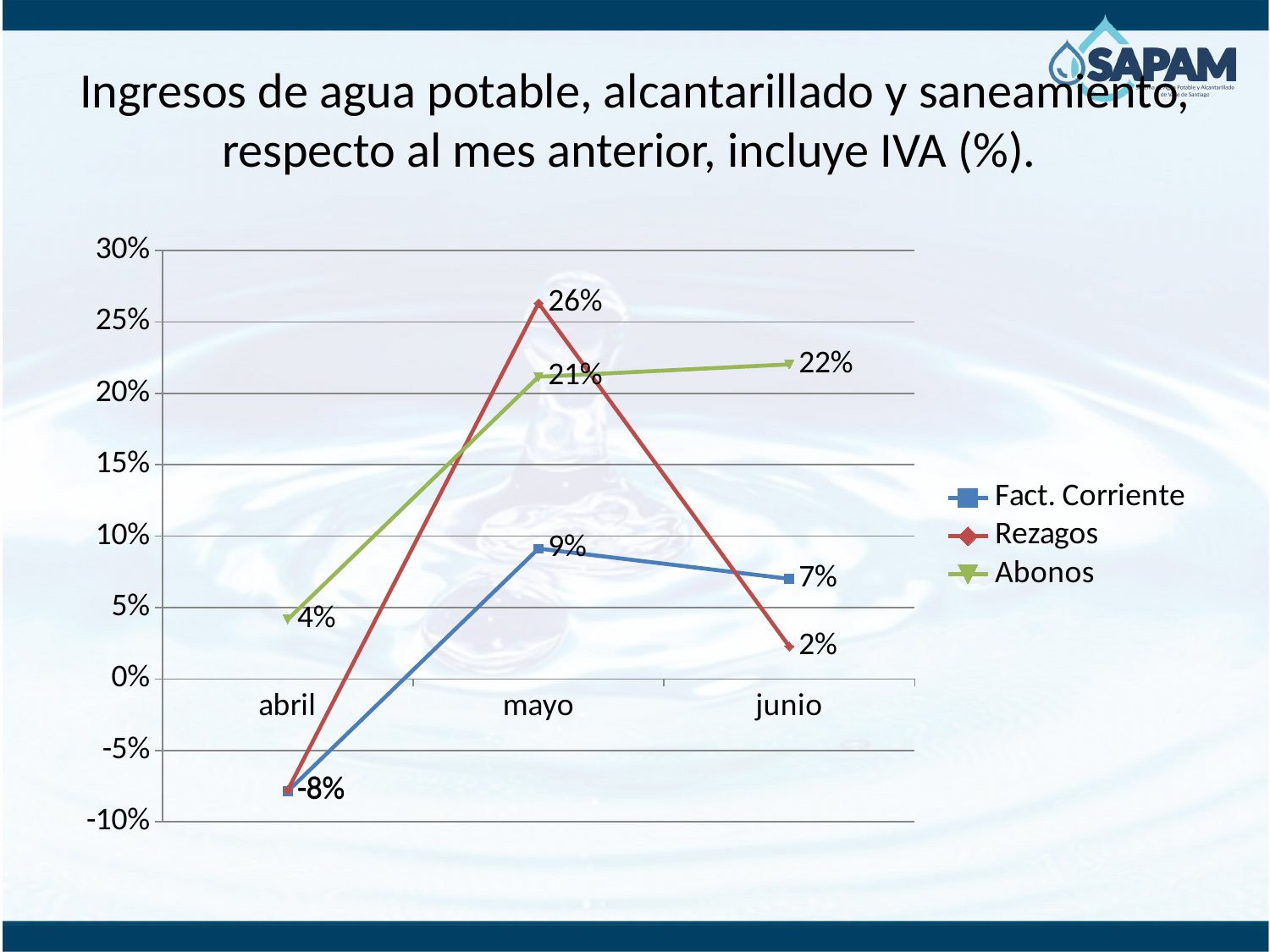
What kind of chart is shown on the slide? line chart What is the value for Abonos in abril? 4% In which month does Rezagos reach its highest value? mayo What is the value for Rezagos in mayo? 26% Is the value for Rezagos in abril greater or less than 0%? less Which is larger in junio, Fact. Corriente or Rezagos? Fact. Corriente How many series does the legend list? 3 How many months are shown on the x axis? 3 What is the difference between the Rezagos value and the Abonos value in mayo? 5% What is the value for Fact. Corriente in mayo? 9% What is the value for Abonos in junio? 22% What is the value for Rezagos in junio? 2%